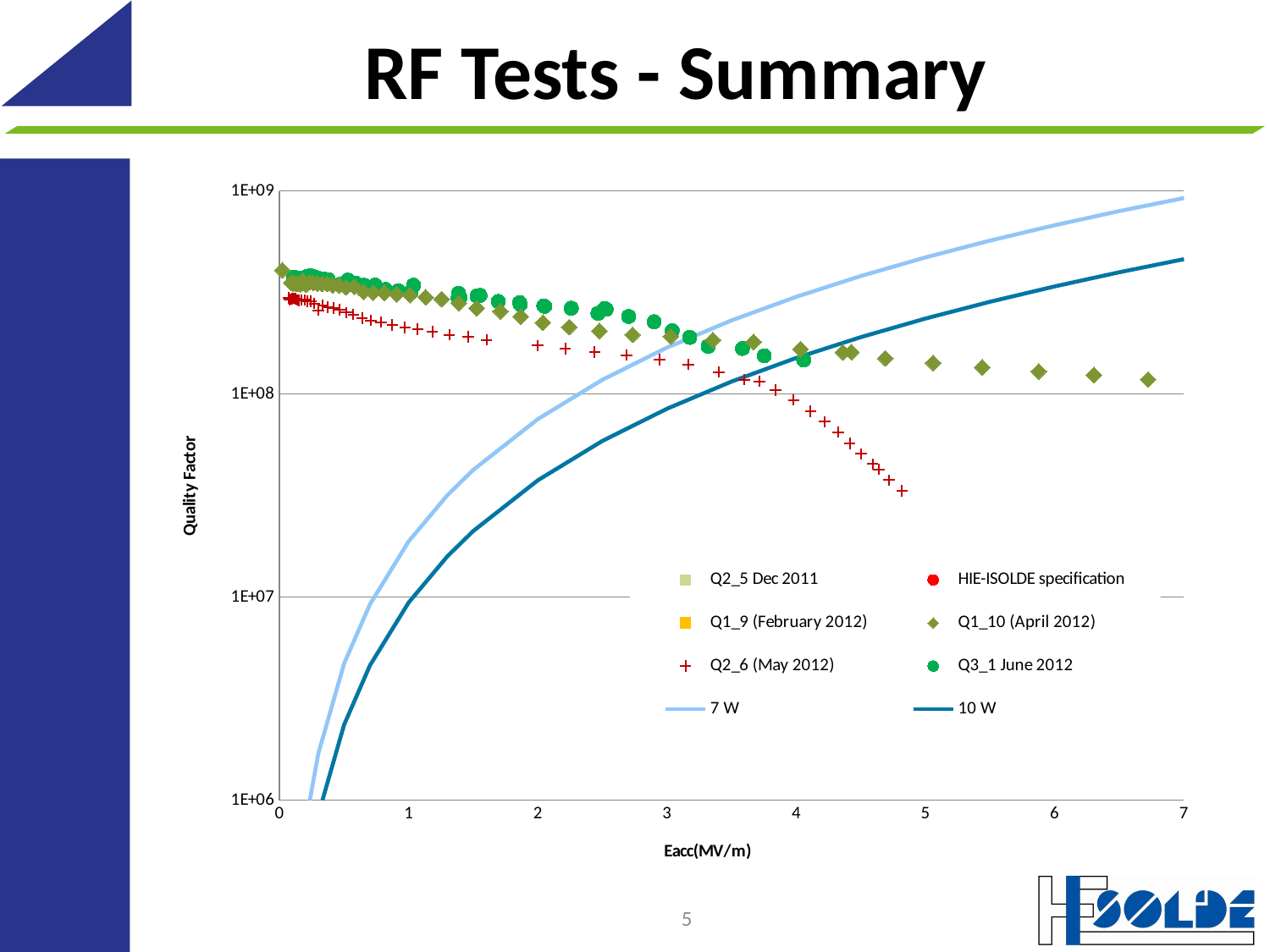
What kind of chart is shown on the slide? Scatter chart Does the 7 W line rise or fall as Eacc increases? Rise What is the label of the x axis of the chart? Eacc(MV/m) Is the Q1_10 (April 2012) value at Eacc of about 6 MV/m greater or less than 1E+08? greater Is the Q2_6 (May 2012) value at Eacc of about 4.5 MV/m greater or less than 1E+08? less How many series does the chart legend list? 8 At Eacc of 1 MV/m, which series has the higher quality factor: Q3_1 June 2012 or Q2_6 (May 2012)? Q3_1 June 2012 At Eacc of 6 MV/m, which is higher: the 7 W line or the Q1_10 (April 2012) points? 7 W Do the Q2_6 (May 2012) values rise or fall as Eacc increases? Fall At Eacc of 4 MV/m, which line is higher: 7 W or 10 W? 7 W Is the 7 W line value at Eacc of 1 MV/m greater or less than 1E+08? less What is the label of the y axis of the chart? Quality Factor